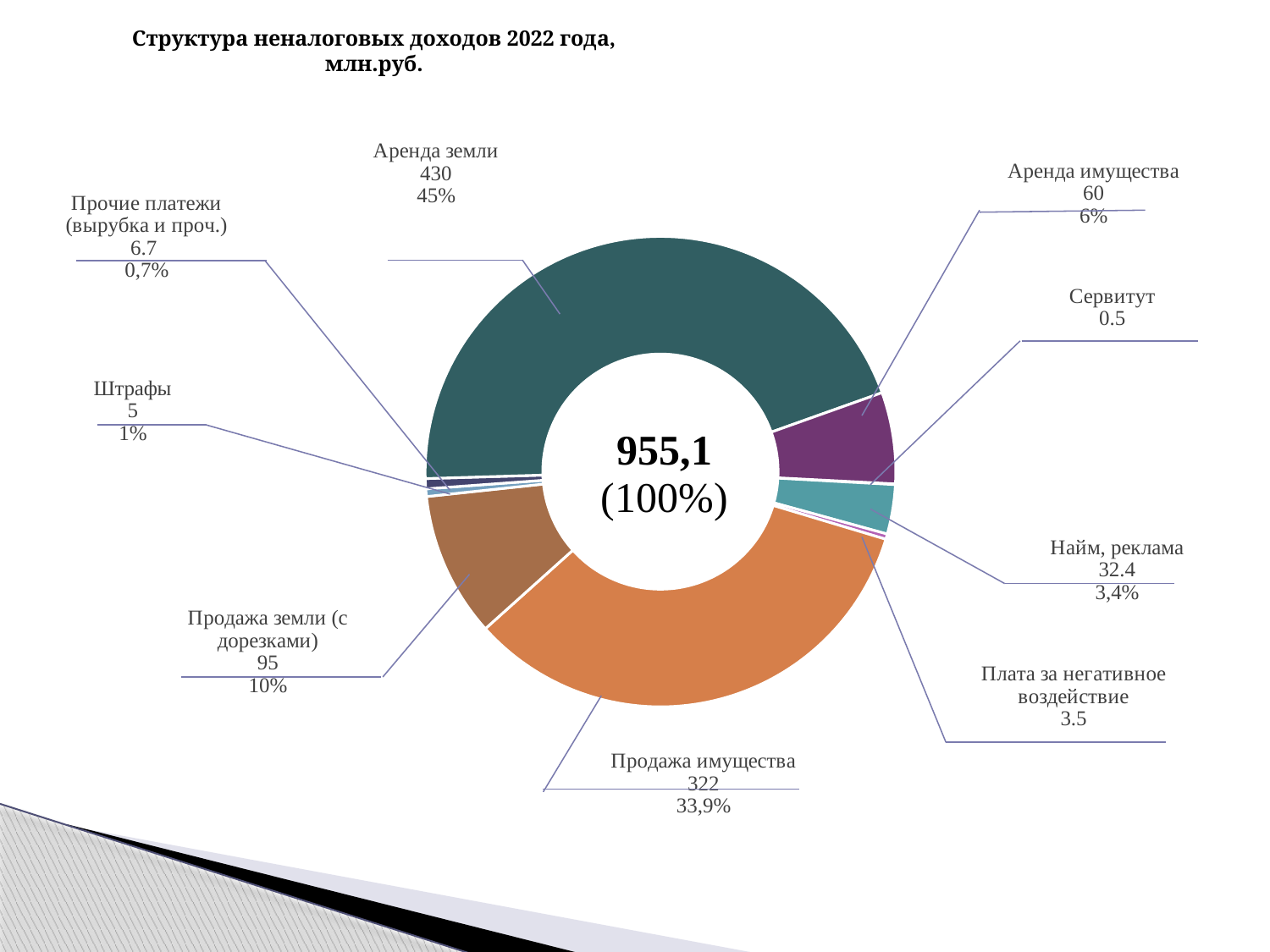
What is the difference between the values for Аренда земли and Продажа имущества? 108 What share of the total does Продажа земли (с дорезками) represent? 10% What is the value for Плата за негативное воздействие? 3.5 Which is larger, the value for Штрафы or the value for Прочие платежи (вырубка и проч.)? Прочие платежи (вырубка и проч.) What is the value for Аренда земли? 430 Which category has the largest value? Аренда земли What share of the total does Аренда имущества represent? 6% What is the value for Найм, реклама? 32.4 What type of chart is shown on the slide? Doughnut (pie) chart How many categories does the chart show? 9 Which category has the smallest value? Сервитут What is the value for Продажа имущества? 322